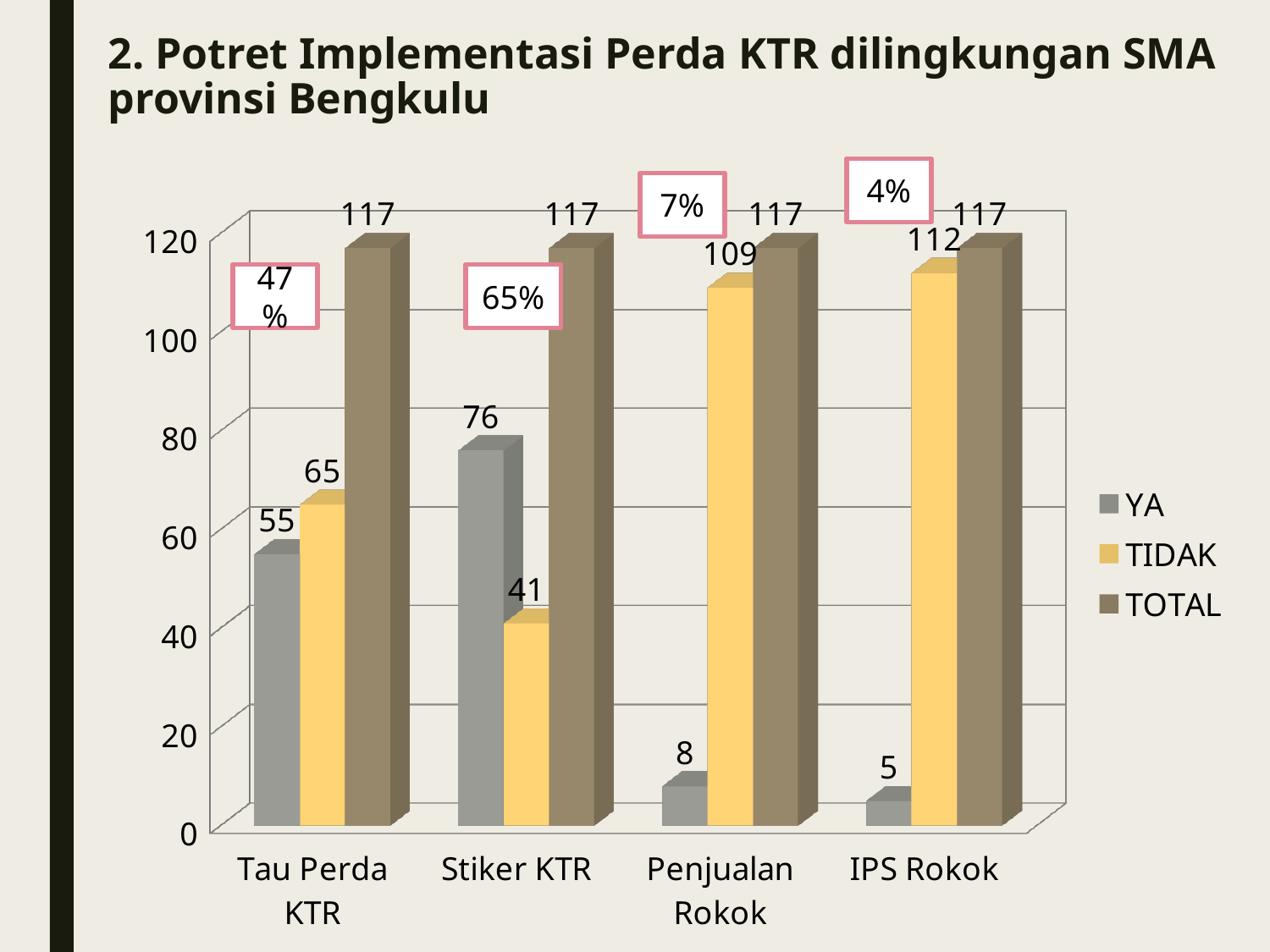
What is the YA value for IPS Rokok? 5 How many categories are shown on the x axis? 4 What is the TOTAL value for each category? 117 What kind of chart is shown on the slide? Bar chart What is the difference between the TIDAK and YA values for Tau Perda KTR? 10 Which category has the lowest TIDAK value? Stiker KTR Which is larger for Stiker KTR, the YA value or the TIDAK value? YA What is the TIDAK value for Stiker KTR? 41 Which category has the highest YA value? Stiker KTR How many series does the legend list? 3 What is the YA value for Tau Perda KTR? 55 What is the TIDAK value for Penjualan Rokok? 109